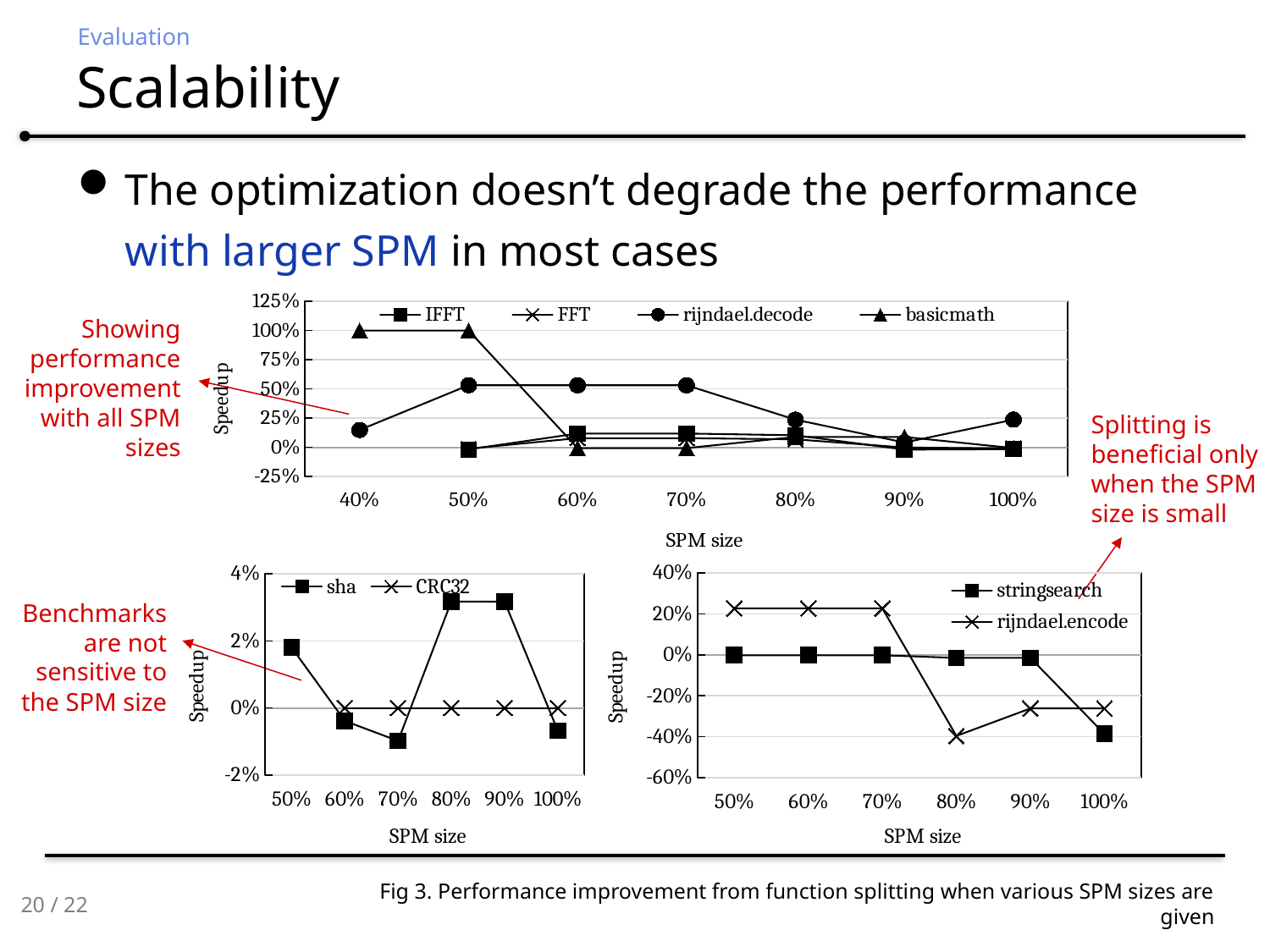
What kind of chart is the top chart? line chart In the top chart, how many SPM size categories are shown on the x axis? 7 In the top chart, how many series does the legend list? 4 In the top chart, is the speedup for basicmath at 40% SPM size greater or less than 75%? greater In the top chart, does the speedup for basicmath rise or fall from 50% to 60% SPM size? fall In the bottom-right chart, is the speedup for rijndael.encode at 50% SPM size greater or less than 20%? greater In the top chart, is the speedup for rijndael.decode at 40% SPM size greater or less than 25%? less In the bottom-left chart, how many SPM size categories are shown on the x axis? 6 In the bottom-right chart, which series are listed in the legend? stringsearch and rijndael.encode In the bottom-left chart, how many series does the legend list? 2 In the top chart, which series has the highest speedup at 50% SPM size? basicmath In the bottom-right chart, which series has the lower speedup at 80% SPM size? rijndael.encode